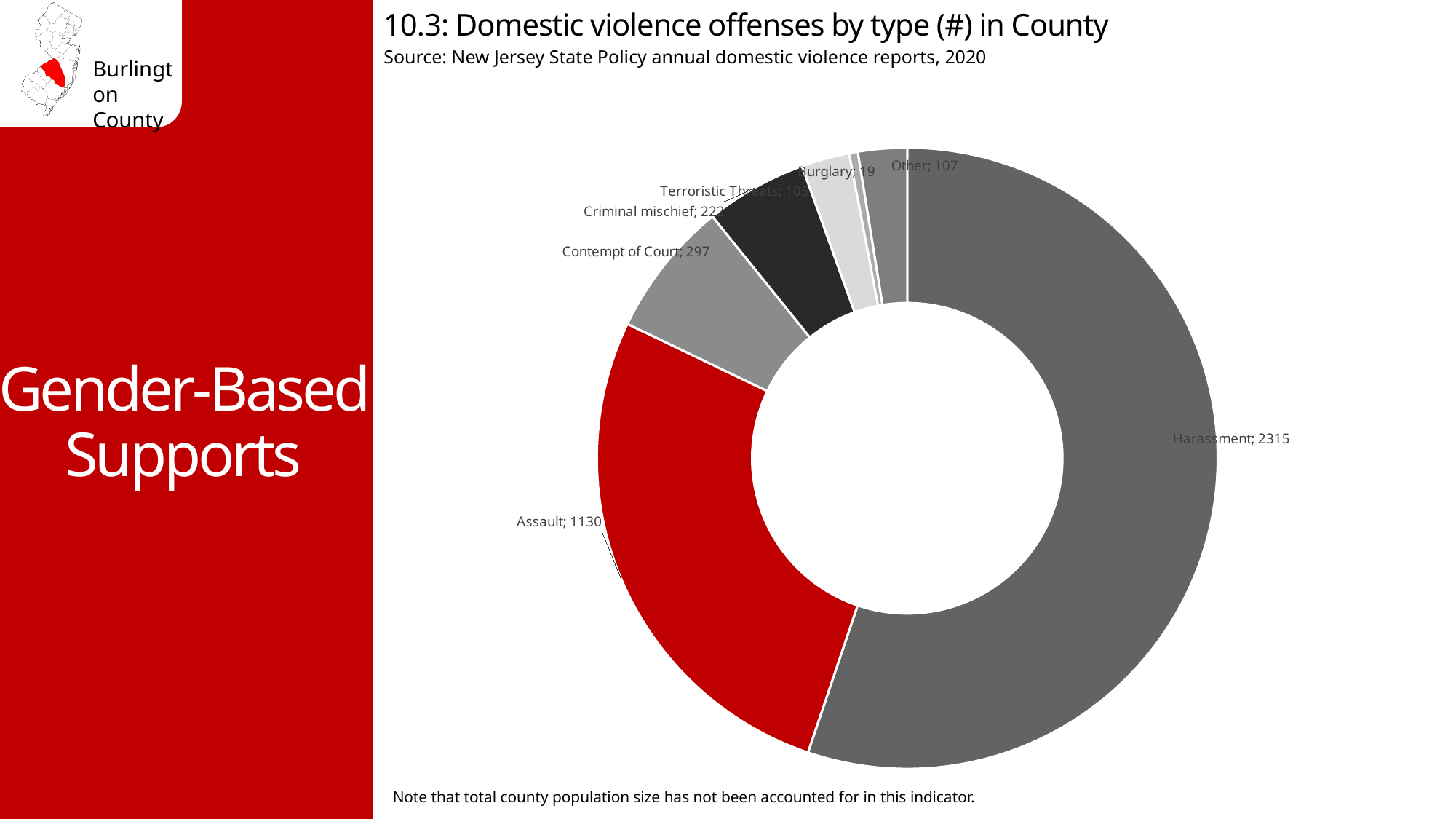
Which offense type has the lowest value? Burglary What is the value for Assault? 1130 How many offense types are shown in the chart? 7 Which is larger, Contempt of Court or Criminal mischief? Contempt of Court What kind of chart is shown on the slide? Pie (doughnut) chart What is the difference between the values for Harassment and Assault? 1185 What is the value for Harassment? 2315 What is the value for Criminal mischief? 222 What is the value for Other? 107 What is the value for Burglary? 19 What is the value for Contempt of Court? 297 Which offense type has the highest value? Harassment